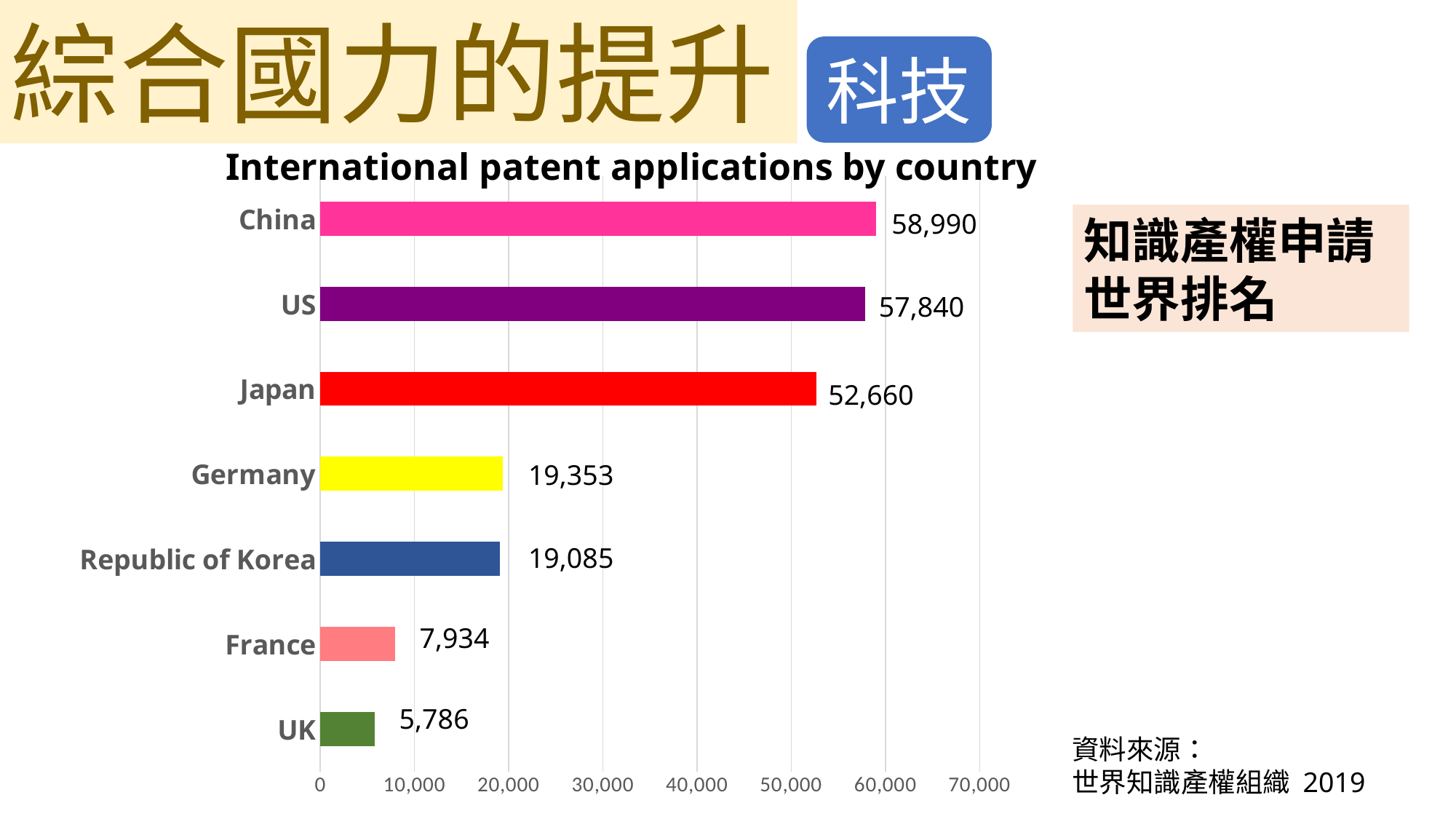
Which country has the lowest number of international patent applications? UK What kind of chart is shown on the slide? Bar chart Which is larger, the value for France or the value for UK? France What is the value for Republic of Korea? 19,085 Which country has the highest number of international patent applications? China How many countries are shown in the chart? 7 What is the value for Japan? 52,660 What is the difference between the values for China and US? 1,150 What is the difference between the values for Germany and Republic of Korea? 268 What is the value for UK? 5,786 Is the value for Japan greater or less than 50,000? greater What is the value for China? 58,990